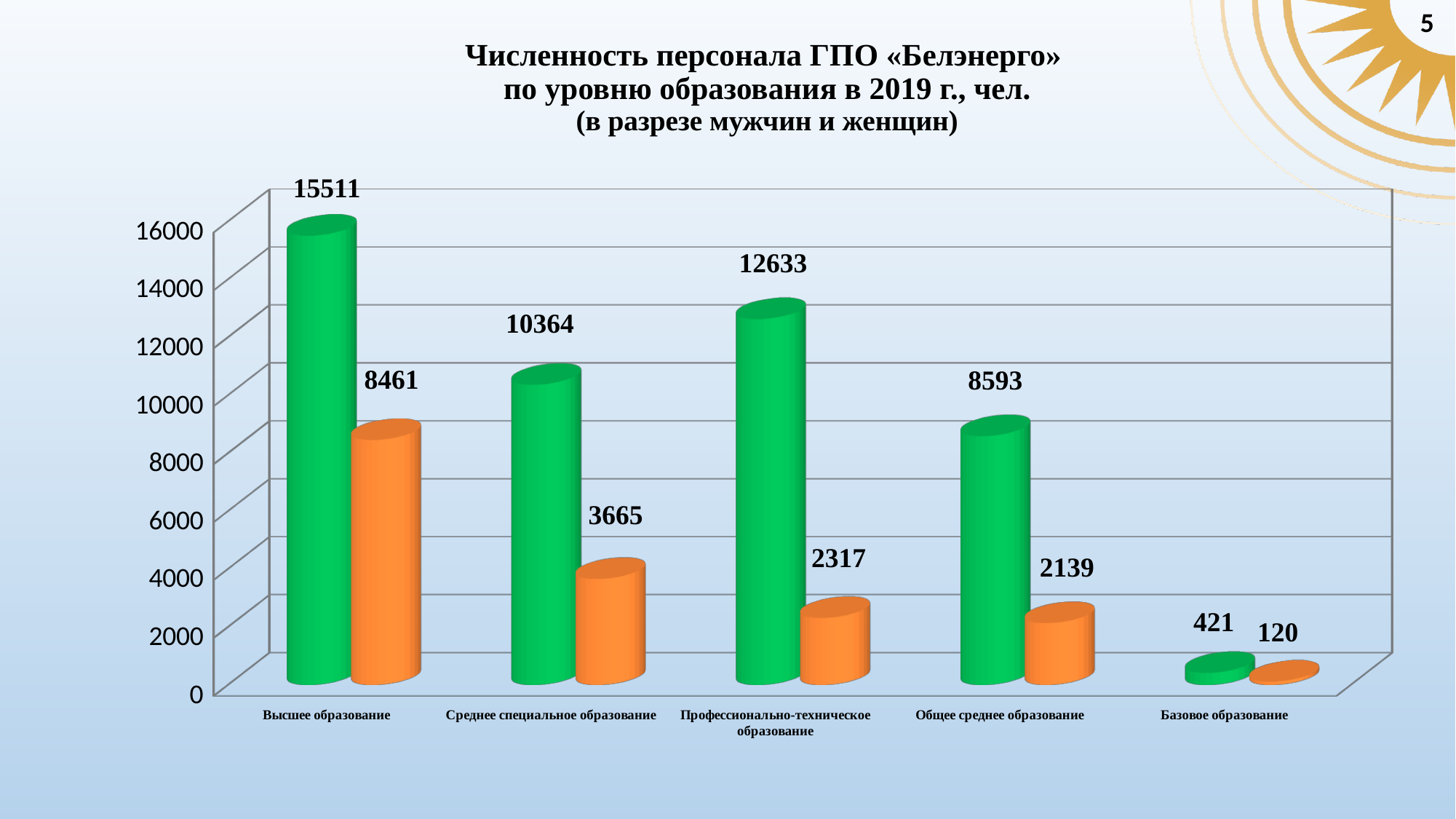
What is the value of the green bar for Профессионально-техническое образование? 12633 What is the value of the orange bar for Базовое образование? 120 Which is larger: the orange bar for Профессионально-техническое образование or the orange bar for Общее среднее образование? Профессионально-техническое образование What year does the chart title say the data refers to? 2019 What is the value of the orange bar for Среднее специальное образование? 3665 What is the difference between the green and orange bars for Высшее образование? 7050 What kind of chart is shown on the slide? Bar chart What is the difference between the green bars for Профессионально-техническое образование and Общее среднее образование? 4040 Which category has the highest green bar? Высшее образование Which category has the lowest orange bar? Базовое образование How many education-level categories are shown on the x axis? 5 What is the value of the green bar for Высшее образование? 15511